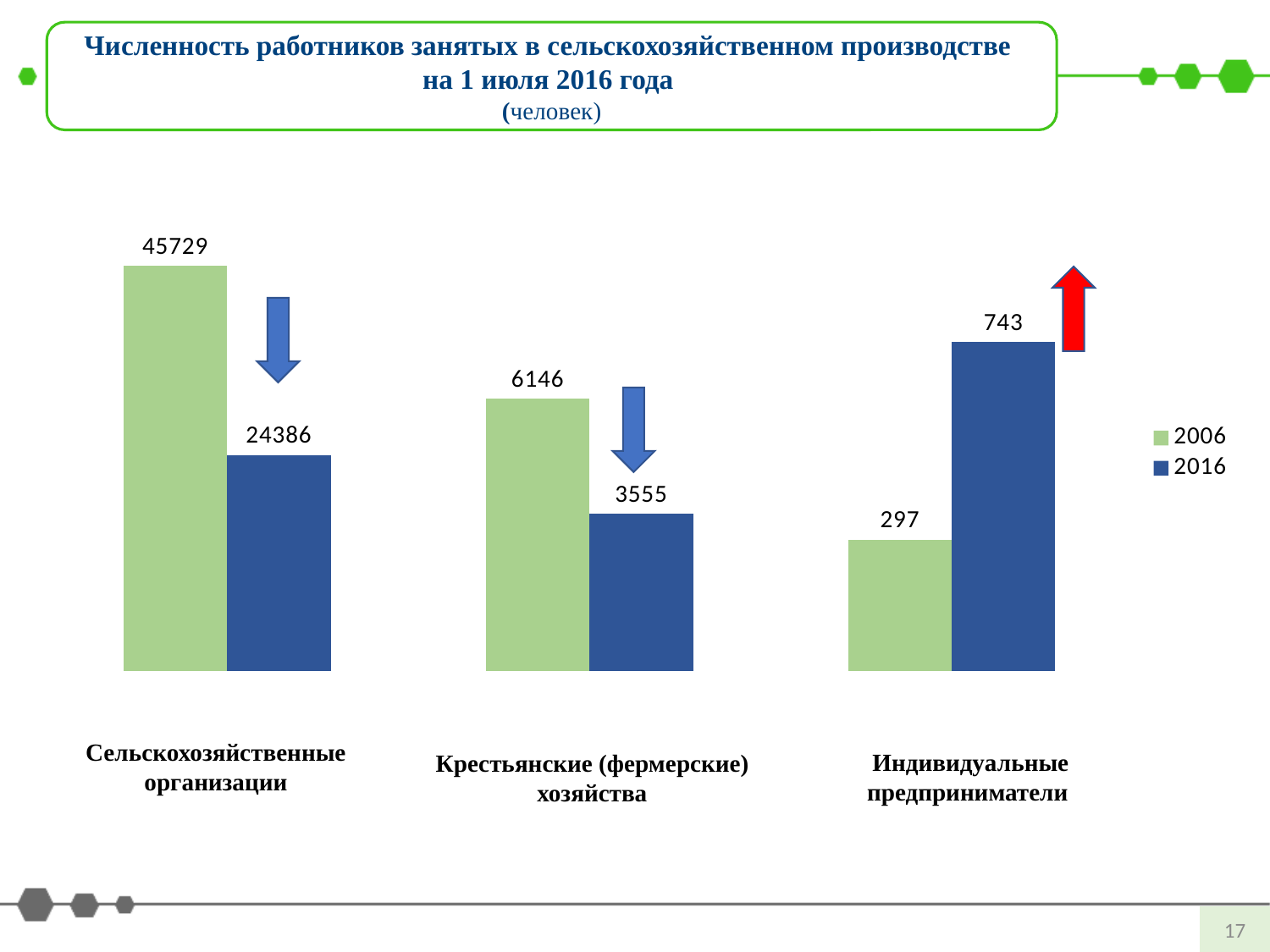
What type of chart is shown on the slide? Bar chart Which category had the highest number of workers in 2006? Сельскохозяйственные организации What was the number of workers in Сельскохозяйственные организации in 2016? 24386 What was the number of workers in Крестьянские (фермерские) хозяйства in 2016? 3555 What was the number of workers in Индивидуальные предприниматели in 2006? 297 Which category had the lowest number of workers in 2016? Индивидуальные предприниматели By how much did the number of workers in Крестьянские (фермерские) хозяйства change from 2006 to 2016? 2591 What is the difference between the 2016 and 2006 values for Индивидуальные предприниматели? 446 For Индивидуальные предприниматели, which year had the larger value, 2006 or 2016? 2016 What was the number of workers in Сельскохозяйственные организации in 2006? 45729 How many categories are shown on the chart? 3 How many series does the legend list? 2